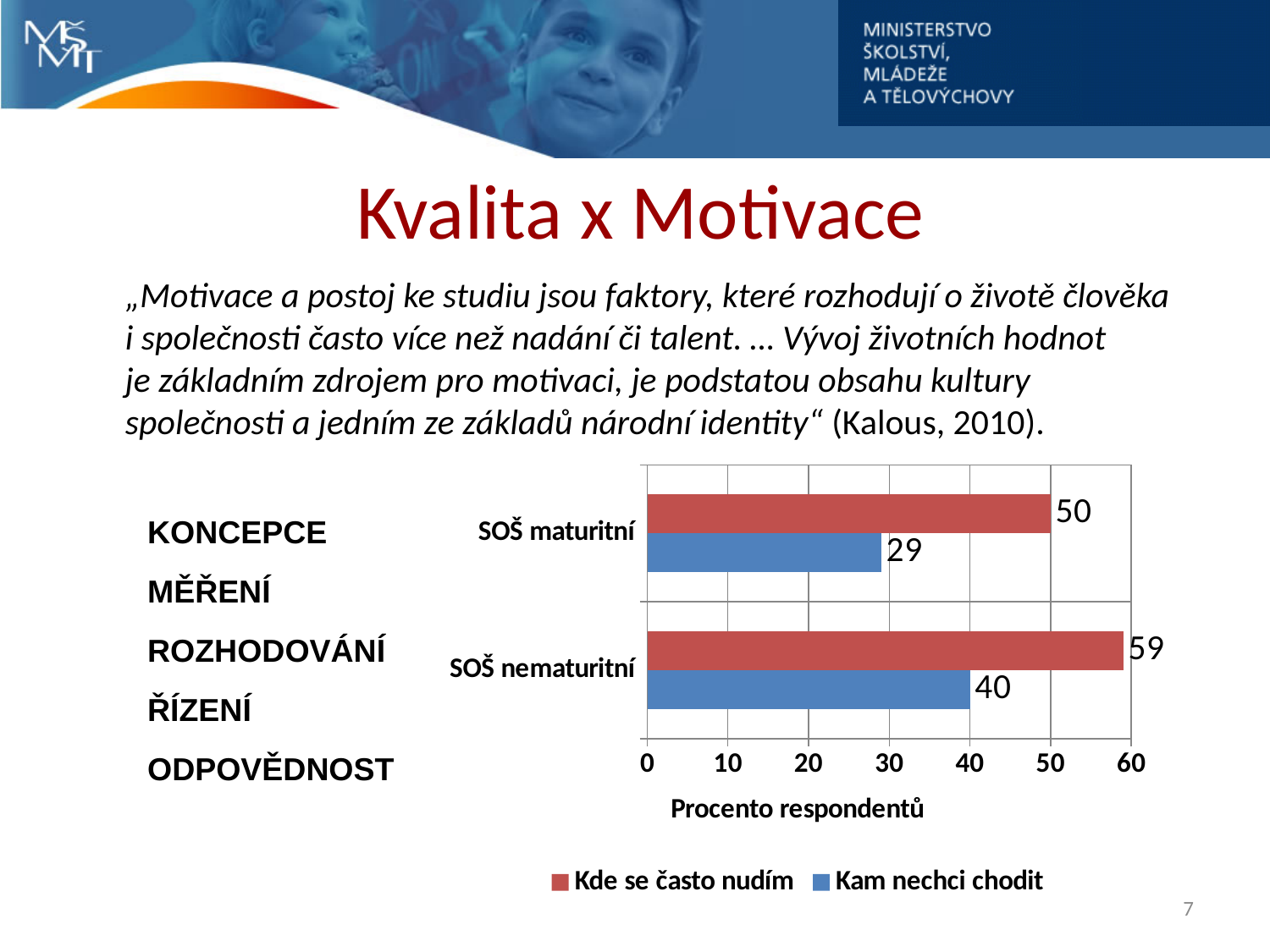
Which category has the highest value for "Kde se často nudím"? SOŠ nematuritní Which category has the lowest value for "Kam nechci chodit"? SOŠ maturitní Which is larger: "Kam nechci chodit" for SOŠ nematuritní or "Kde se často nudím" for SOŠ maturitní? Kde se často nudím for SOŠ maturitní How many series does the legend list? 2 What is the value for "Kde se často nudím" for SOŠ maturitní? 50 What is the difference between the "Kde se často nudím" values for SOŠ nematuritní and SOŠ maturitní? 9 What is the difference between the "Kde se často nudím" and "Kam nechci chodit" values for SOŠ maturitní? 21 What is the value for "Kam nechci chodit" for SOŠ nematuritní? 40 What is the value for "Kde se často nudím" for SOŠ nematuritní? 59 What kind of chart is shown on the slide? Bar chart How many categories are shown on the chart? 2 What is the value for "Kam nechci chodit" for SOŠ maturitní? 29